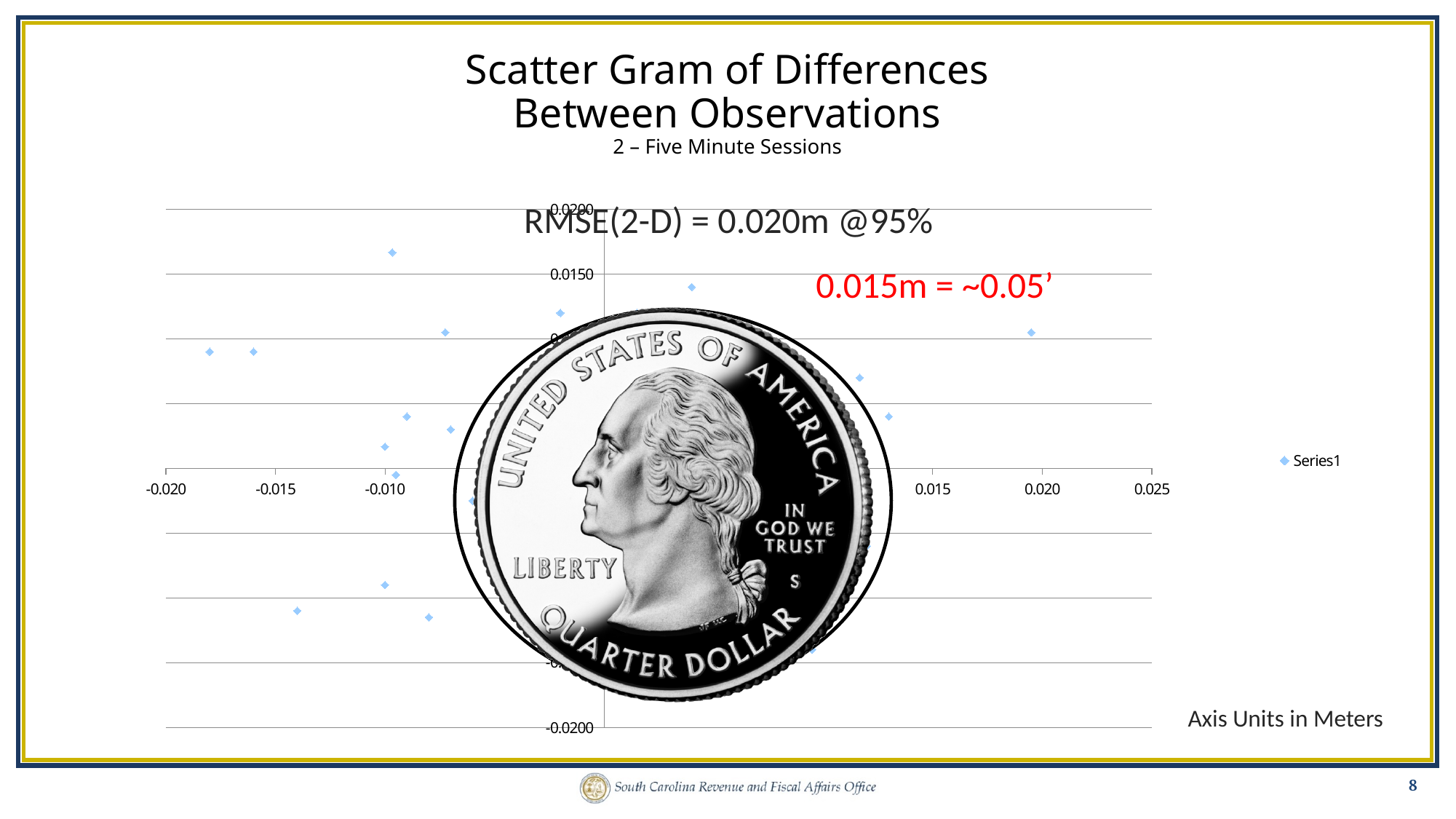
What is the name of the series shown in the chart legend? Series1 What kind of chart is shown on the slide? Scatter chart What is the highest tick value shown on the x axis of the chart? 0.025 What units are the chart axes in, according to the note on the slide? Meters What is the highest tick value shown on the y axis of the chart? 0.0200 How many series does the chart legend list? 1 According to the text on the chart, what is the RMSE(2-D) value at 95%? 0.020m What is the lowest tick value shown on the y axis of the chart? -0.0200 What is the lowest tick value shown on the x axis of the chart? -0.020 What is the title of the chart on the slide? Scatter Gram of Differences Between Observations